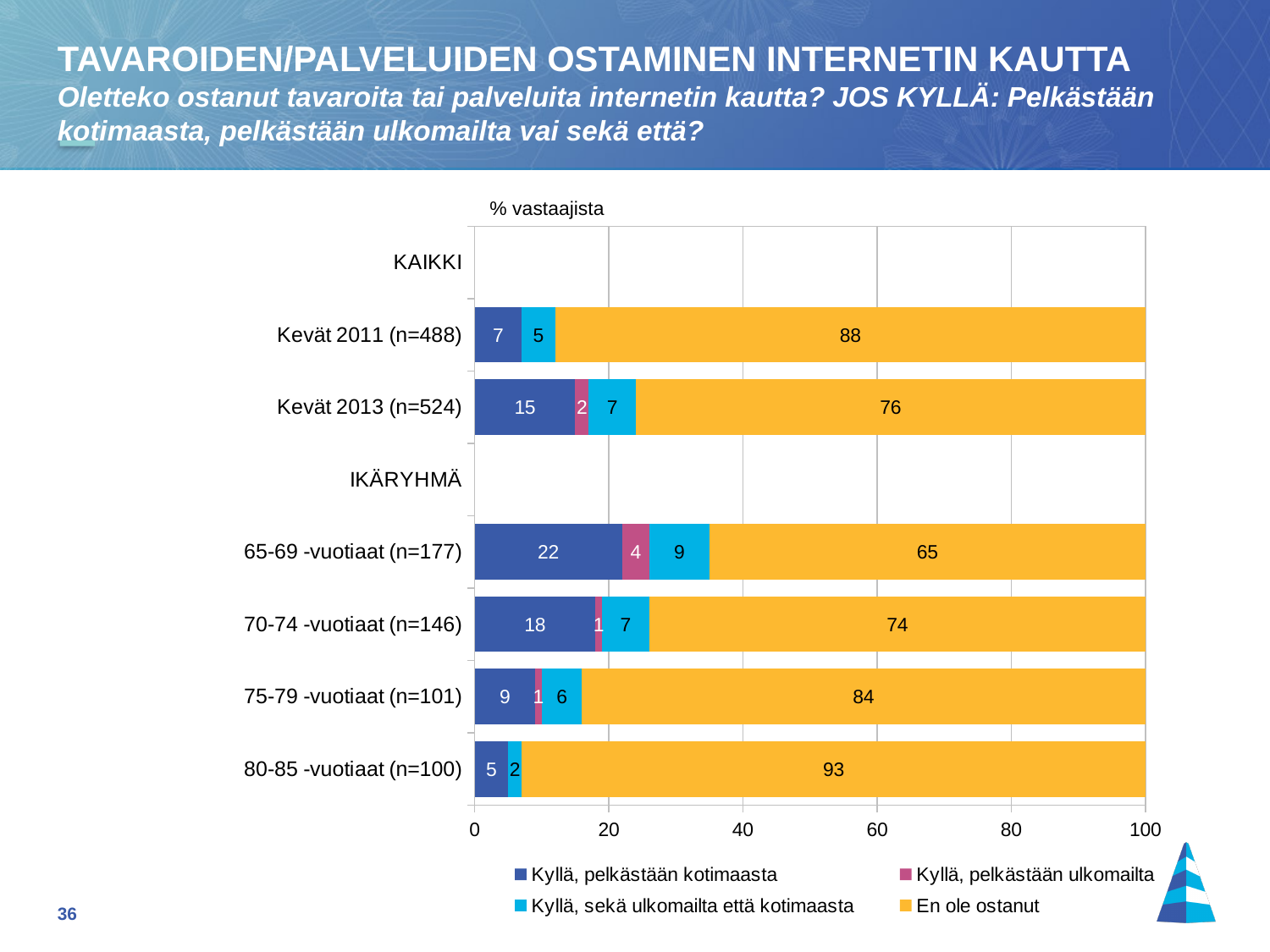
What is the total of the stacked bar for 75-79 -vuotiaat (n=101)? 100 What is the value of 'En ole ostanut' for Kevät 2013 (n=524)? 76 What kind of chart is shown on the slide? stacked bar chart Which age group has the highest value for 'En ole ostanut'? 80-85 -vuotiaat (n=100) How many series does the legend list? 4 Is the 'En ole ostanut' value for 65-69 -vuotiaat (n=177) greater or less than 60? greater Which age group has the lowest value for 'Kyllä, pelkästään kotimaasta'? 80-85 -vuotiaat (n=100) What is the difference in 'En ole ostanut' between Kevät 2011 (n=488) and Kevät 2013 (n=524)? 12 What is the value of 'Kyllä, sekä ulkomailta että kotimaasta' for 70-74 -vuotiaat (n=146)? 7 What is the value of 'Kyllä, pelkästään kotimaasta' for 65-69 -vuotiaat (n=177)? 22 What is the label on the value axis of the chart? % vastaajista Is the 'Kyllä, pelkästään kotimaasta' value larger for 65-69 -vuotiaat (n=177) or for 75-79 -vuotiaat (n=101)? 65-69 -vuotiaat (n=177)